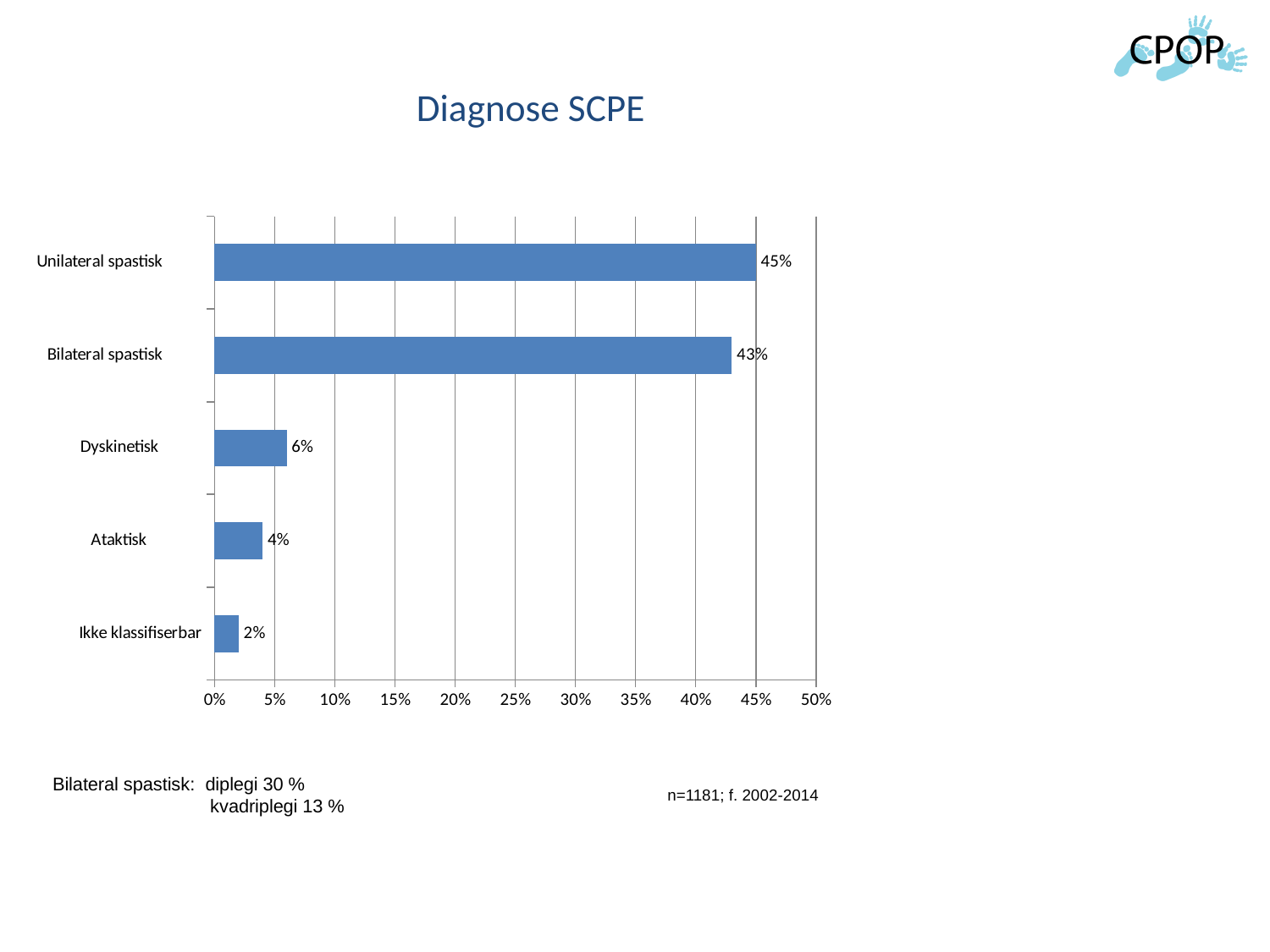
What kind of chart is shown on the slide? Bar chart What is the value for Ikke klassifiserbar? 2% What is the title of the slide? Diagnose SCPE What is the value for Bilateral spastisk? 43% Which category has the highest value? Unilateral spastisk Which category has the lowest value? Ikke klassifiserbar Which is larger, the value for Dyskinetisk or the value for Ataktisk? Dyskinetisk What is the value for Dyskinetisk? 6% How many categories are shown in the chart? 5 What is the value for Ataktisk? 4% What is the value for Unilateral spastisk? 45% What is the difference between the values for Unilateral spastisk and Bilateral spastisk? 2%